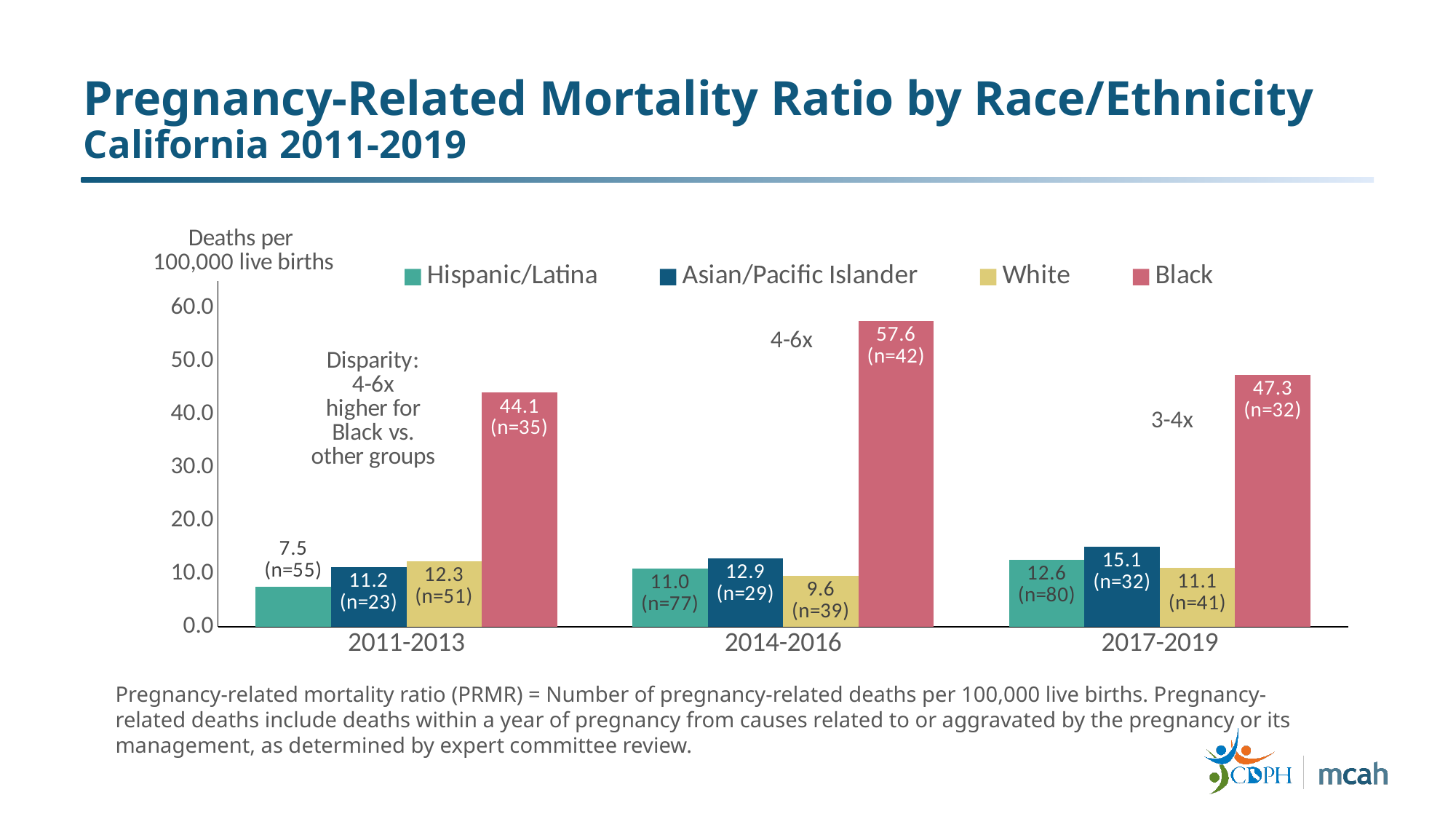
What kind of chart is shown on the slide? Bar chart What is the pregnancy-related mortality ratio for Black women in 2014-2016? 57.6 What is the difference between the Black and White values in 2011-2013? 31.8 Which race/ethnicity group has the highest mortality ratio in 2017-2019? Black Which is larger in 2014-2016: the Hispanic/Latina value or the Asian/Pacific Islander value? Asian/Pacific Islander Which race/ethnicity group has the lowest mortality ratio in 2011-2013? Hispanic/Latina How many series does the legend list? 4 What is the value for Hispanic/Latina women in 2011-2013? 7.5 How many time periods are shown on the x axis? 3 What is the value for Asian/Pacific Islander women in 2017-2019? 15.1 What is the value for White women in 2014-2016? 9.6 Does the Hispanic/Latina value rise or fall across the three time periods? Rise